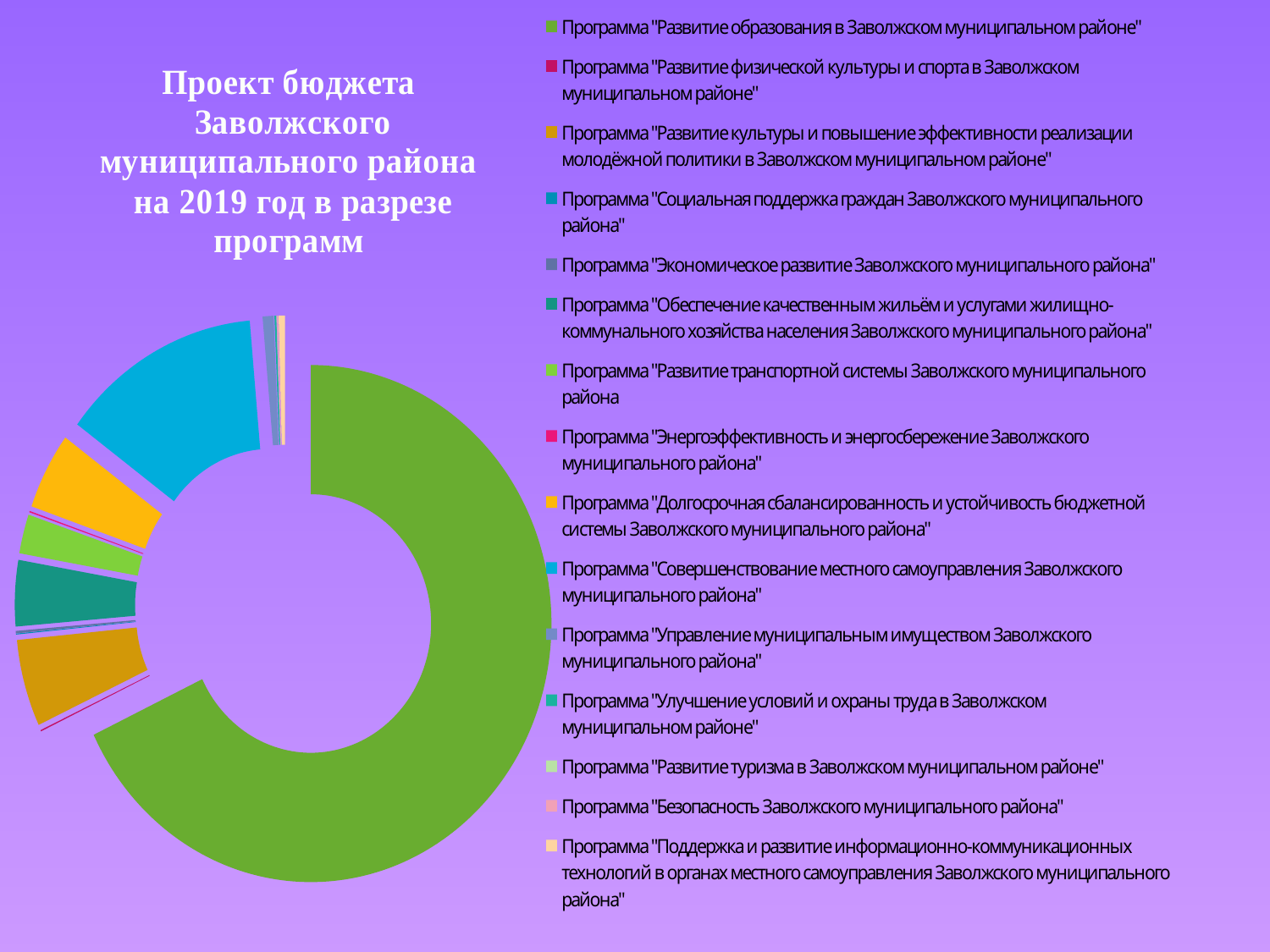
Which is larger: the slice for "Развитие образования" or the slice for "Совершенствование местного самоуправления"? Развитие образования Which is larger: the slice for "Развитие культуры и повышение эффективности реализации молодёжной политики" or the slice for "Энергоэффективность и энергосбережение"? Развитие культуры и повышение эффективности реализации молодёжной политики What colour represents the program "Развитие образования в Заволжском муниципальном районе" in the legend? Green For which year is the budget project shown in the chart? 2019 What is the title of the chart on the slide? Проект бюджета Заволжского муниципального района на 2019 год в разрезе программ Does the largest slice of the chart take up more or less than half of the doughnut? more Which is larger: the slice for "Совершенствование местного самоуправления" or the slice for "Развитие транспортной системы"? Совершенствование местного самоуправления What kind of chart is shown on the slide? Doughnut (pie) chart Which program has the largest share of the budget in the chart? Программа "Развитие образования в Заволжском муниципальном районе" How many programs does the legend list? 15